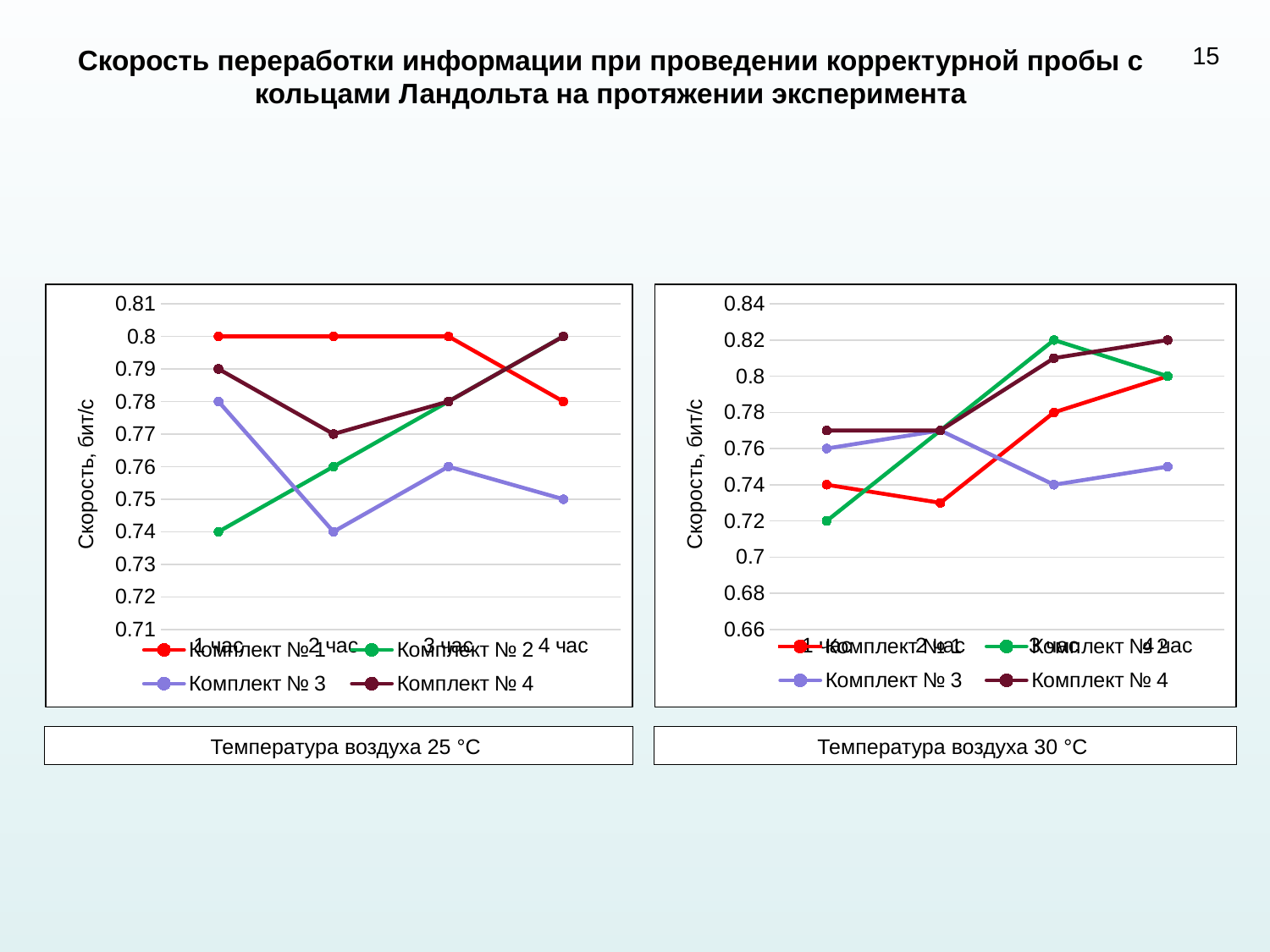
In the right chart (Температура воздуха 30 °C), is the value for Комплект № 2 at 1 час greater or less than 0.74? less In the left chart (Температура воздуха 25 °C), which series has the highest value at 2 час? Комплект №1 How many series does the legend of the right chart (Температура воздуха 30 °C) list? 4 What type of chart is the left chart (Температура воздуха 25 °C)? line chart How many time points are shown on the x axis of the left chart (Температура воздуха 25 °C)? 4 In the left chart (Температура воздуха 25 °C), what is the value for Комплект №1 at 4 час? 0.78 In the right chart (Температура воздуха 30 °C), which is larger at 3 час: Комплект № 2 or Комплект № 3? Комплект № 2 In the left chart (Температура воздуха 25 °C), what is the difference between Комплект №1 and Комплект № 2 at 1 час? 0.06 In the left chart (Температура воздуха 25 °C), which series has the lowest value at 2 час? Комплект № 3 In the left chart (Температура воздуха 25 °C), what is the value for Комплект № 2 at 1 час? 0.74 In the left chart (Температура воздуха 25 °C), does the value for Комплект № 2 rise or fall from 1 час to 4 час? rise In the right chart (Температура воздуха 30 °C), what is the value for Комплект № 2 at 3 час? 0.82